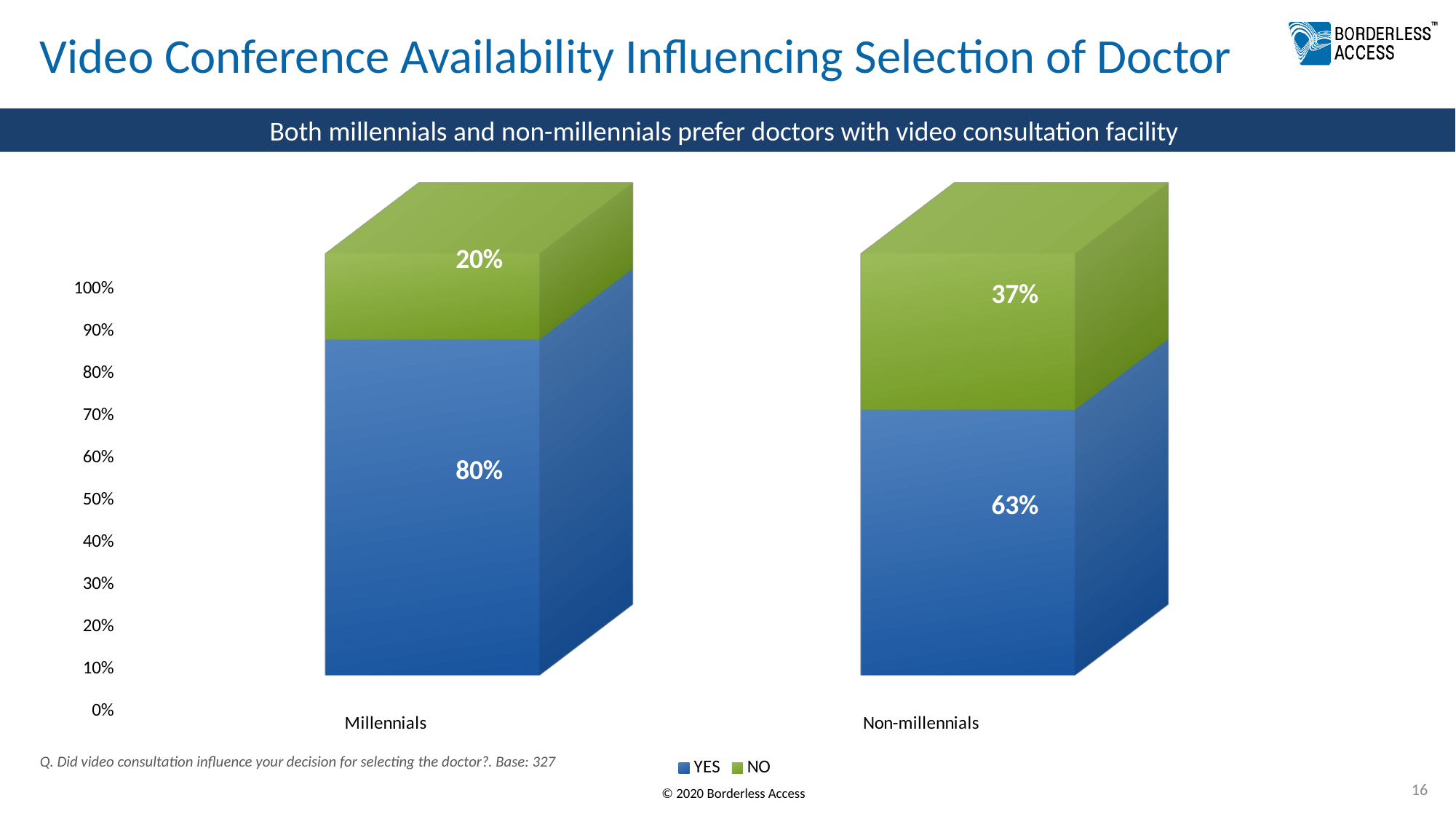
How many series does the legend list? 2 What is the total of the stacked bar for Millennials? 100% What is the difference between the YES share for Millennials and the YES share for Non-millennials? 17% What percentage of Non-millennials answered YES? 63% What kind of chart is shown on the slide? Stacked bar chart What percentage of Millennials answered YES? 80% What is the difference between the NO share for Non-millennials and the NO share for Millennials? 17% What percentage of Non-millennials answered NO? 37% How many groups (categories) are shown on the x axis? 2 Which group has the higher YES share, Millennials or Non-millennials? Millennials Which group has the lower NO share? Millennials What percentage of Millennials answered NO? 20%